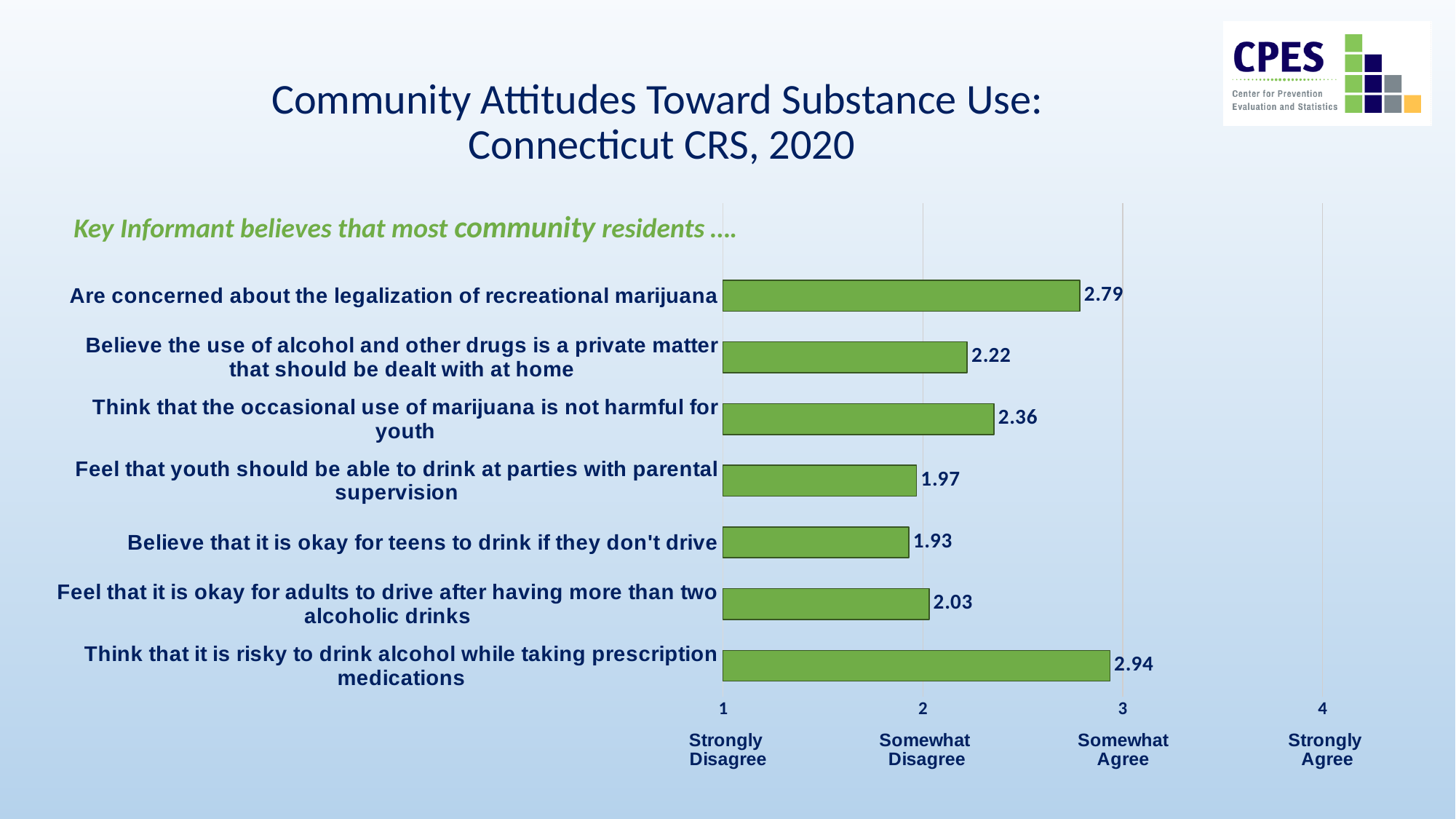
Which category has the lowest value? Believe that it is okay for teens to drink if they don't drive What is the value for "Are concerned about the legalization of recreational marijuana"? 2.79 Which is larger: the value for "Think that the occasional use of marijuana is not harmful for youth" or the value for "Believe the use of alcohol and other drugs is a private matter that should be dealt with at home"? Think that the occasional use of marijuana is not harmful for youth What is the value for "Feel that it is okay for adults to drive after having more than two alcoholic drinks"? 2.03 What label does the axis show at the value 4? Strongly Agree What is the difference between the values for "Think that it is risky to drink alcohol while taking prescription medications" and "Are concerned about the legalization of recreational marijuana"? 0.15 Which category has the highest value? Think that it is risky to drink alcohol while taking prescription medications What is the difference between the values for "Feel that it is okay for adults to drive after having more than two alcoholic drinks" and "Believe that it is okay for teens to drink if they don't drive"? 0.10 What kind of chart is shown on the slide? Bar chart Is the value for "Feel that youth should be able to drink at parties with parental supervision" greater or less than 2? less How many categories are shown in the chart? 7 What is the value for "Believe that it is okay for teens to drink if they don't drive"? 1.93